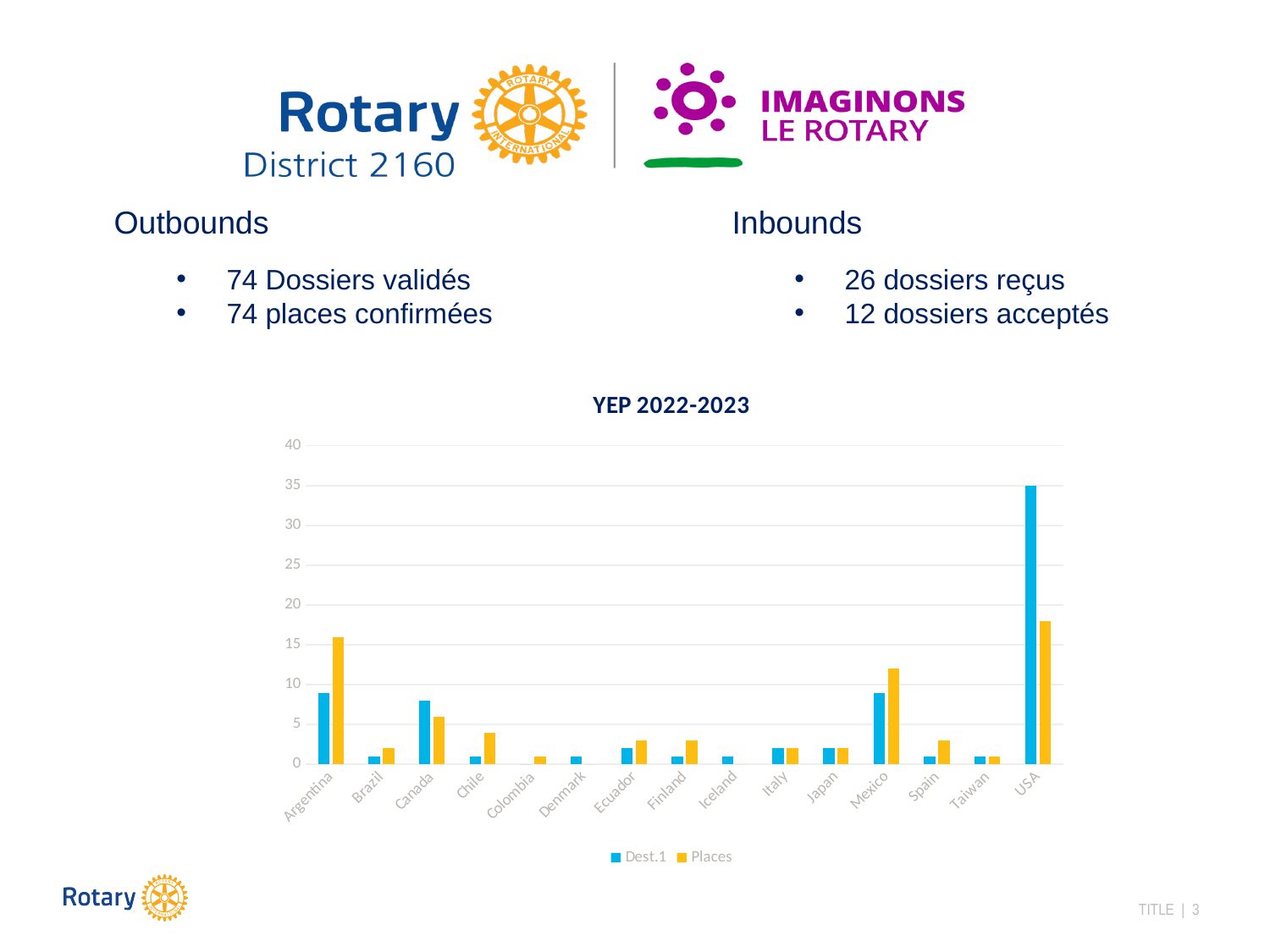
Which colour represents the Places series in the chart? yellow Which is larger for Argentina, the Dest.1 value or the Places value? Places How many countries are shown on the x axis of the chart? 15 Which country has the highest Places value? USA Which country has the highest Dest.1 value? USA Is the Places value for Argentina greater or less than 10? greater Which is larger for Canada, the Dest.1 value or the Places value? Dest.1 How many series does the chart legend list? 2 Is the Dest.1 value for USA greater or less than 30? greater What is the title of the chart? YEP 2022-2023 Is the Places value for Mexico greater or less than 15? less What kind of chart is shown on the slide? bar chart